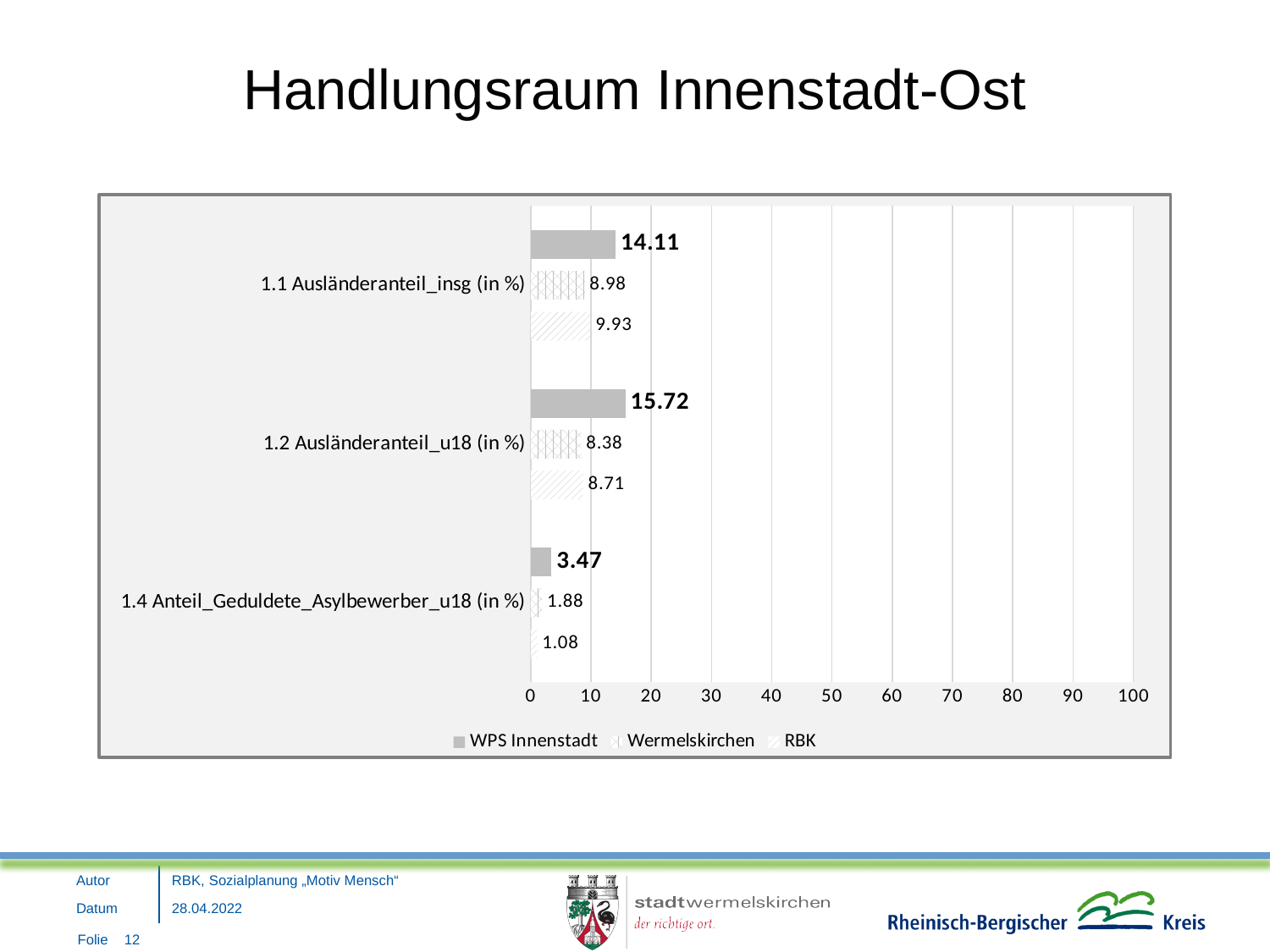
What is the title of the slide containing the chart? Handlungsraum Innenstadt-Ost In the category 1.2 Ausländeranteil_u18 (in %), which is larger: the value for Wermelskirchen or the value for RBK? RBK What is the difference between the WPS Innenstadt value and the Wermelskirchen value in the category 1.1 Ausländeranteil_insg (in %)? 5.13 Which category has the lowest value for RBK? 1.4 Anteil_Geduldete_Asylbewerber_u18 (in %) How many categories are shown on the chart? 3 What kind of chart is shown on the slide? Bar chart What is the value for Wermelskirchen in the category 1.2 Ausländeranteil_u18 (in %)? 8.38 Which category has the highest value for WPS Innenstadt? 1.2 Ausländeranteil_u18 (in %) What is the value for WPS Innenstadt in the category 1.1 Ausländeranteil_insg (in %)? 14.11 How many series does the legend list? 3 Is the value for WPS Innenstadt in the category 1.2 Ausländeranteil_u18 (in %) greater or less than 10? greater What is the value for RBK in the category 1.4 Anteil_Geduldete_Asylbewerber_u18 (in %)? 1.08